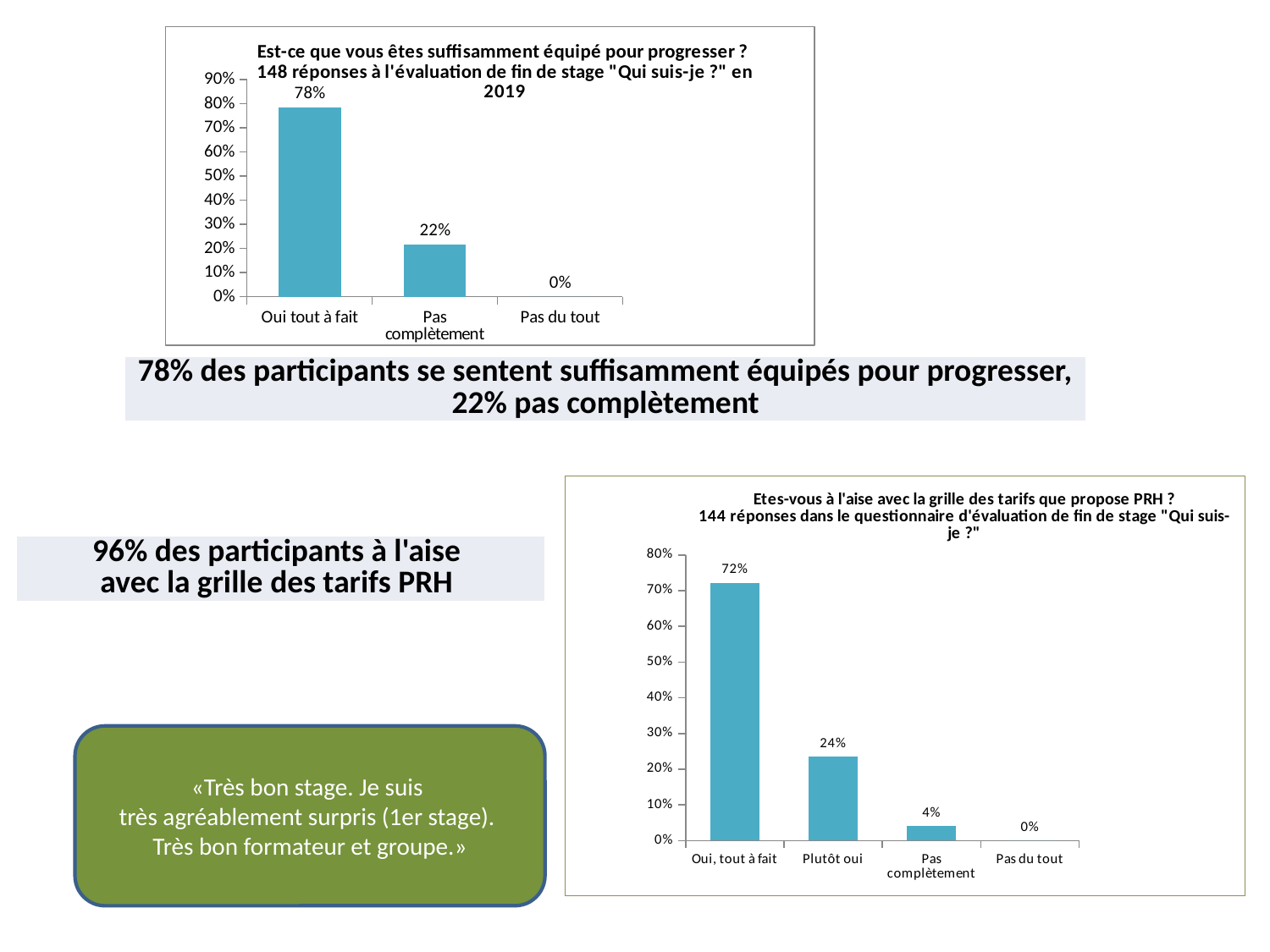
In the top chart ("Est-ce que vous êtes suffisamment équipé pour progresser ?"), what is the difference between "Oui tout à fait" and "Pas complètement"? 56% In the bottom chart ("Etes-vous à l'aise avec la grille des tarifs que propose PRH ?"), how many categories are shown on the x axis? 4 In the bottom chart ("Etes-vous à l'aise avec la grille des tarifs que propose PRH ?"), which category has the lowest value? Pas du tout What kind of chart is the bottom chart ("Etes-vous à l'aise avec la grille des tarifs que propose PRH ?")? Bar chart In the top chart ("Est-ce que vous êtes suffisamment équipé pour progresser ?"), which category has the highest value? Oui tout à fait In the bottom chart ("Etes-vous à l'aise avec la grille des tarifs que propose PRH ?"), do the values rise or fall from left to right along the x axis? Fall In the top chart ("Est-ce que vous êtes suffisamment équipé pour progresser ?"), how many categories are shown on the x axis? 3 In the top chart ("Est-ce que vous êtes suffisamment équipé pour progresser ?"), what is the value for "Oui tout à fait"? 78% In the top chart ("Est-ce que vous êtes suffisamment équipé pour progresser ?"), what is the value for "Pas complètement"? 22% In the bottom chart ("Etes-vous à l'aise avec la grille des tarifs que propose PRH ?"), what is the value for "Plutôt oui"? 24% In the bottom chart ("Etes-vous à l'aise avec la grille des tarifs que propose PRH ?"), which is larger: "Oui, tout à fait" or "Plutôt oui"? Oui, tout à fait In the bottom chart ("Etes-vous à l'aise avec la grille des tarifs que propose PRH ?"), what is the value for "Pas complètement"? 4%